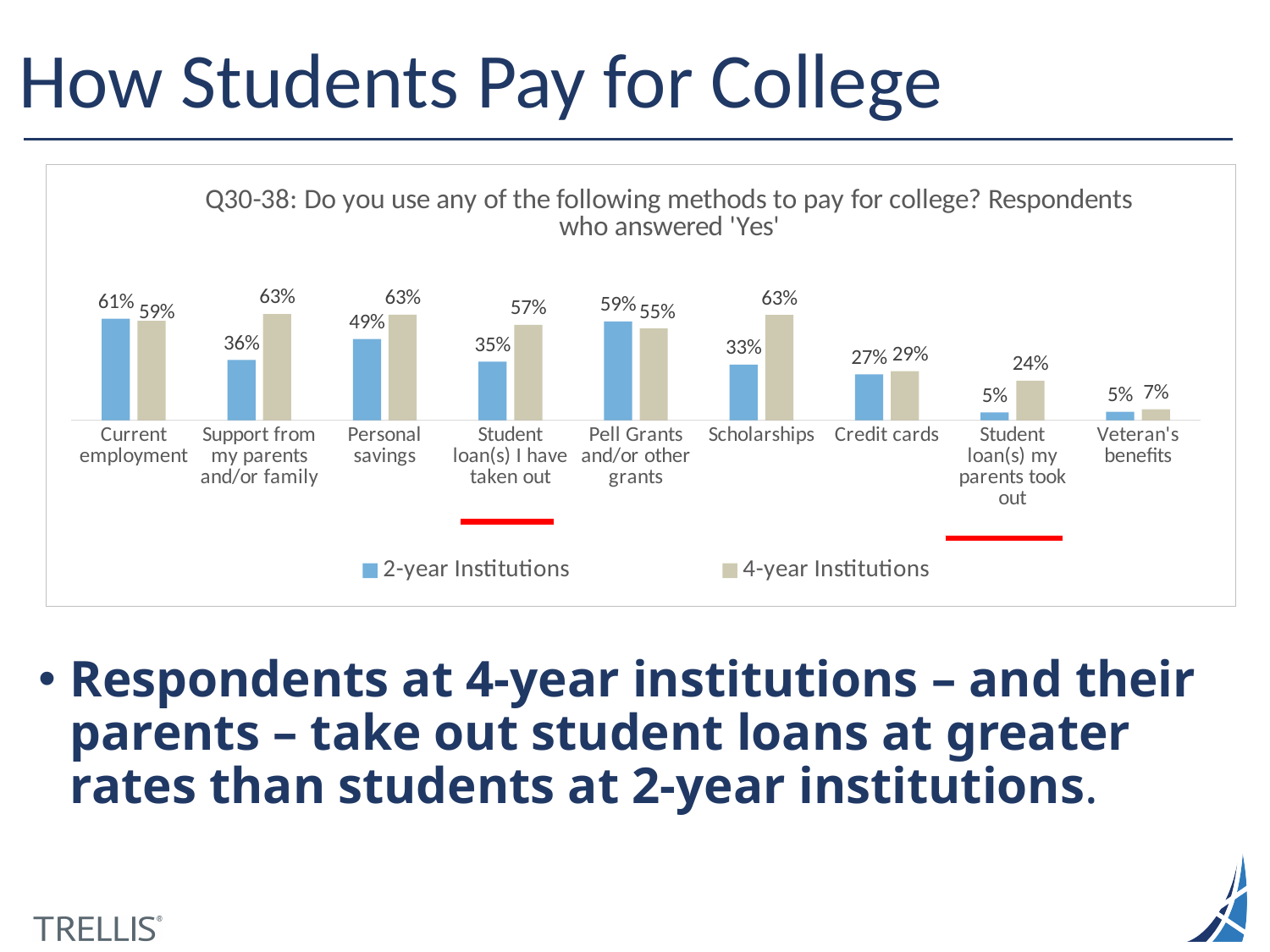
Which colour represents 4-year institutions in the chart? Beige (tan) Which payment method has the highest value for 2-year institutions? Current employment Which payment method has the lowest value for 4-year institutions? Veteran's benefits How many payment methods (categories) are shown on the x axis? 9 What is the value for 'Student loan(s) my parents took out' for 4-year institutions? 24% What percentage of respondents at 4-year institutions use scholarships to pay for college? 63% What is the difference between 2-year and 4-year institutions for credit cards? 2 percentage points What kind of chart is shown on the slide? Bar chart How many series does the legend list? 2 What is the difference between 4-year and 2-year institutions for 'Student loan(s) I have taken out'? 22 percentage points For Pell Grants and/or other grants, which is larger: the value for 2-year institutions or 4-year institutions? 2-year Institutions What percentage of respondents at 2-year institutions use current employment to pay for college? 61%